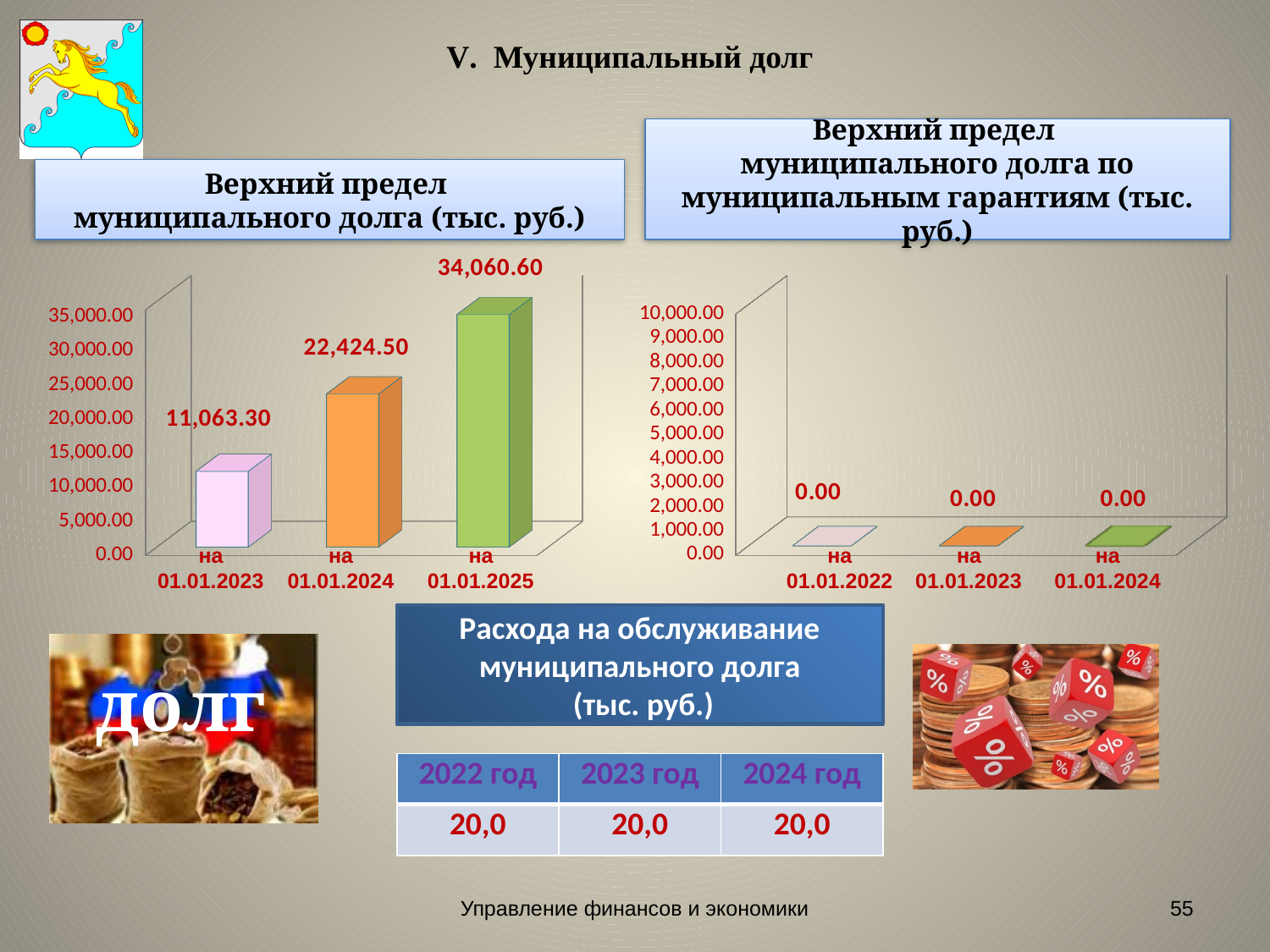
In the chart 'Верхний предел муниципального долга (тыс. руб.)', which category has the lowest value? на 01.01.2023 In the chart 'Верхний предел муниципального долга (тыс. руб.)', what is the value for на 01.01.2025? 34,060.60 In the chart 'Верхний предел муниципального долга по муниципальным гарантиям (тыс. руб.)', what is the highest value shown on the vertical axis? 10,000.00 What kind of chart is 'Верхний предел муниципального долга по муниципальным гарантиям (тыс. руб.)'? bar chart In the chart 'Верхний предел муниципального долга (тыс. руб.)', how many categories are shown? 3 In the chart 'Верхний предел муниципального долга (тыс. руб.)', what is the value for на 01.01.2024? 22,424.50 In the chart 'Верхний предел муниципального долга (тыс. руб.)', do the values rise or fall from left to right along the x axis? rise In the chart 'Верхний предел муниципального долга (тыс. руб.)', what is the value for на 01.01.2023? 11,063.30 In the chart 'Верхний предел муниципального долга (тыс. руб.)', what is the difference between the values for на 01.01.2024 and на 01.01.2023? 11,361.20 In the chart 'Верхний предел муниципального долга по муниципальным гарантиям (тыс. руб.)', what is the value for на 01.01.2023? 0.00 In the chart 'Верхний предел муниципального долга (тыс. руб.)', what is the difference between the values for на 01.01.2025 and на 01.01.2023? 22,997.30 In the chart 'Верхний предел муниципального долга (тыс. руб.)', which category has the highest value? на 01.01.2025